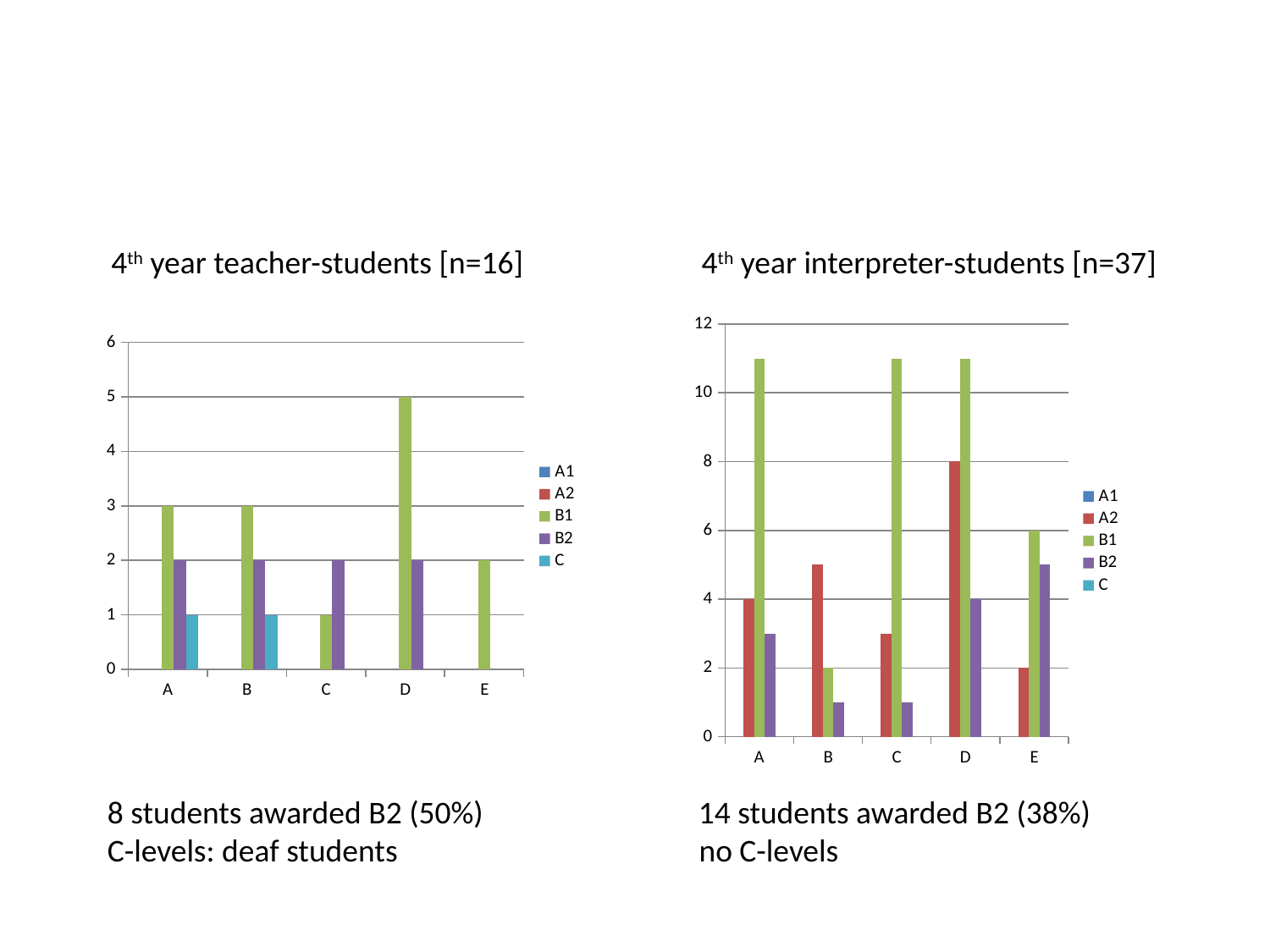
In the 4th year teacher-students chart, which categories have a bar for series C? A and B In the 4th year interpreter-students chart, what is the value of B1 for category E? 6 In the 4th year teacher-students chart, what is the difference between the B1 values for D and C? 4 How many series does the legend of the 4th year interpreter-students chart list? 5 In the 4th year interpreter-students chart, is the B1 value for category A greater or less than 10? greater In the 4th year interpreter-students chart, what is the value of A2 for category D? 8 In the 4th year interpreter-students chart, which category has the highest A2 value? D In the 4th year interpreter-students chart, which is larger for category B: A2 or B1? A2 In the 4th year teacher-students chart, what is the value of B1 for category D? 5 In the 4th year teacher-students chart, which category has the highest B1 value? D In the 4th year teacher-students chart, what is the value of B2 for category C? 2 What type of chart is the 4th year teacher-students chart? Bar chart